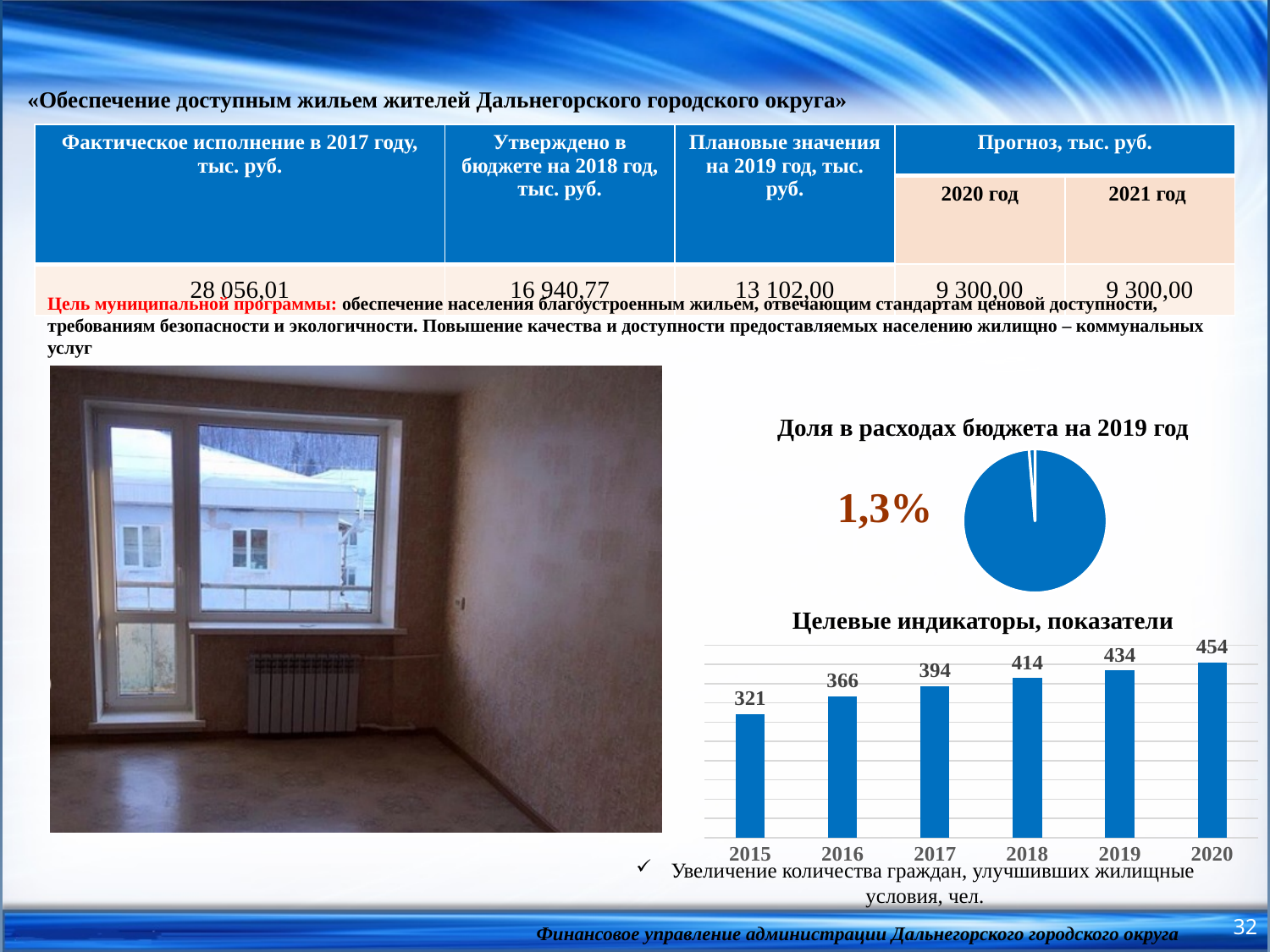
In the chart titled "Целевые индикаторы, показатели", which is larger, the value for 2016 or the value for 2018? 2018 In the chart titled "Целевые индикаторы, показатели", what is the value for 2020? 454 How many years are shown in the chart titled "Целевые индикаторы, показатели"? 6 What kind of chart is the one titled "Целевые индикаторы, показатели"? bar chart In the chart titled "Целевые индикаторы, показатели", what is the value for 2017? 394 What share is shown next to the pie chart titled "Доля в расходах бюджета на 2019 год"? 1,3% In the chart titled "Целевые индикаторы, показатели", what is the difference between the values for 2019 and 2018? 20 In the chart titled "Целевые индикаторы, показатели", which year has the lowest value? 2015 In the chart titled "Целевые индикаторы, показатели", what is the value for 2015? 321 In the chart titled "Целевые индикаторы, показатели", what is the difference between the values for 2020 and 2015? 133 In the chart titled "Целевые индикаторы, показатели", do the values rise or fall from 2015 to 2020? rise In the chart titled "Целевые индикаторы, показатели", which year has the highest value? 2020